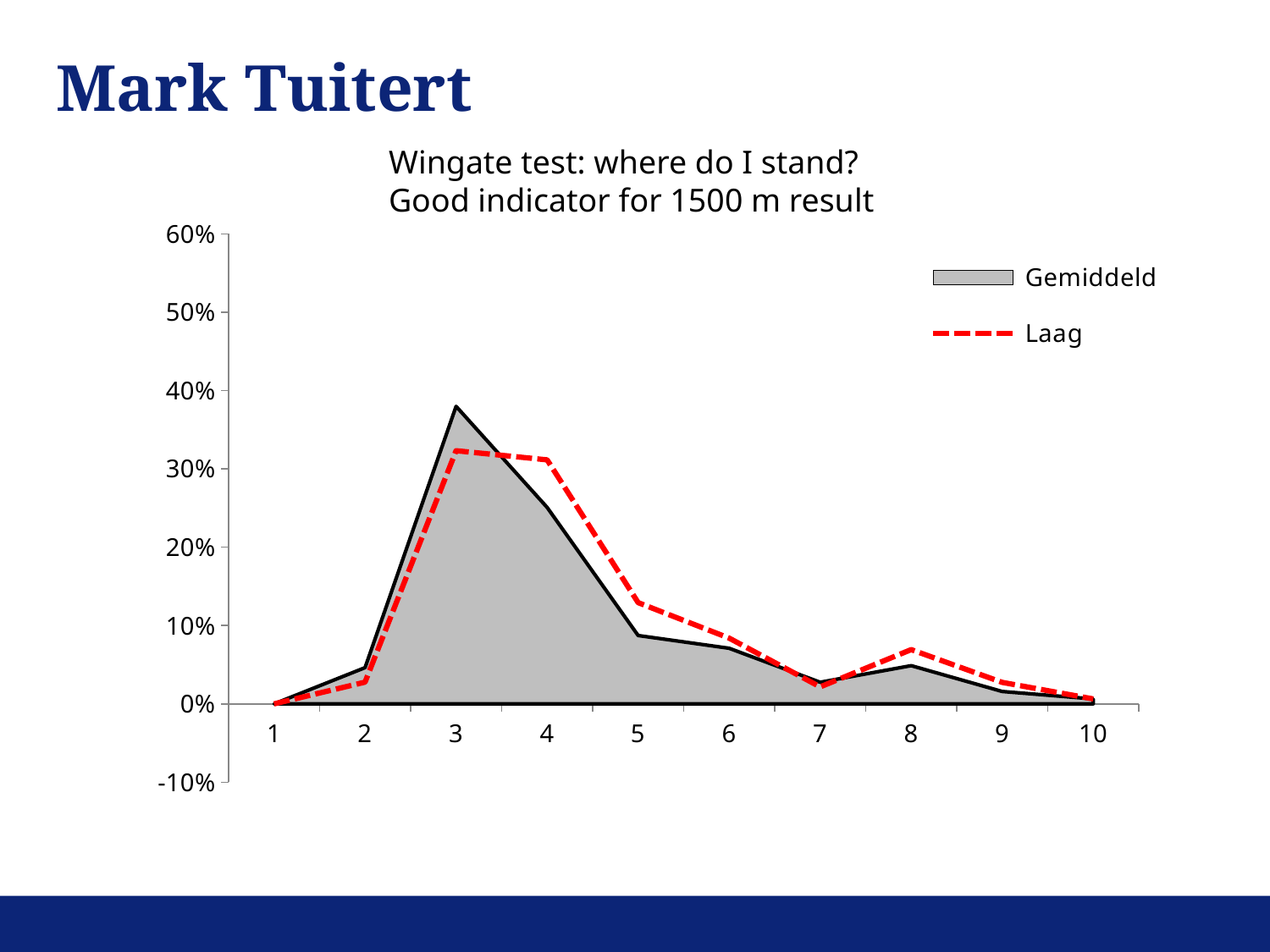
Is the Laag value at category 5 greater or less than 10%? greater Does the Gemiddeld series rise or fall from category 3 to category 7? fall At category 5, which series has the larger value, Gemiddeld or Laag? Laag At which x-axis category does the Gemiddeld series reach its highest value? 3 How many series does the legend list? 2 How many points are plotted along the x axis for each series? 10 Is the Gemiddeld value at category 3 greater or less than 30%? greater Is the Laag value at category 8 greater or less than 10%? less What is the title of the chart? Wingate test: where do I stand? Good indicator for 1500 m result What kind of chart is used to show the Gemiddeld series? area chart At category 3, which series has the larger value, Gemiddeld or Laag? Gemiddeld What are the two series named in the legend? Gemiddeld and Laag